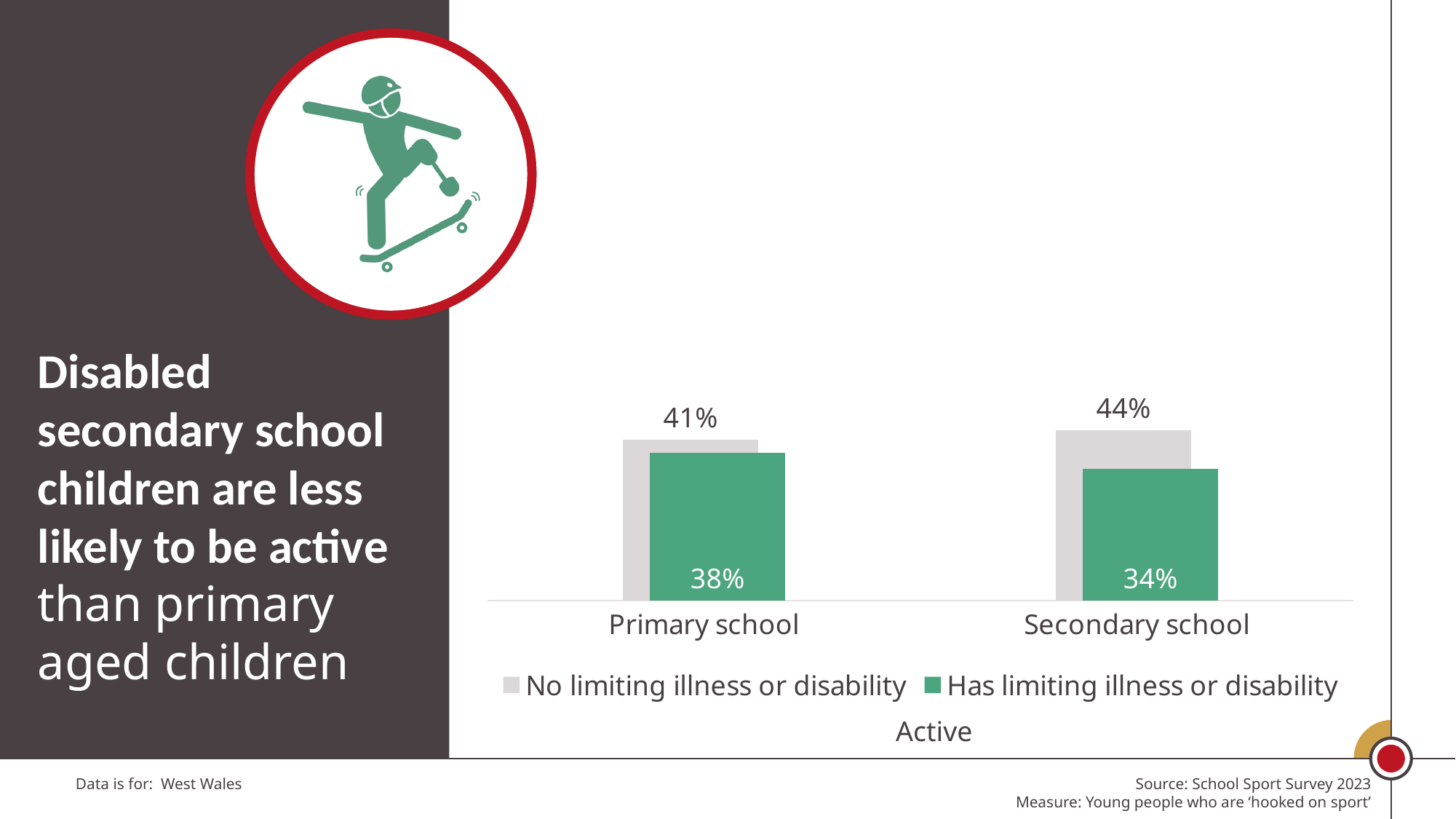
What is the value for 'No limiting illness or disability' at Primary school? 41% What kind of chart is shown on the slide? Bar chart Which category has the highest value for 'No limiting illness or disability'? Secondary school What is the value for 'Has limiting illness or disability' at Secondary school? 34% What is the difference between the 'No limiting illness or disability' and 'Has limiting illness or disability' values at Secondary school? 10% Which is larger: the 'Has limiting illness or disability' value at Primary school or at Secondary school? Primary school How many series does the legend list? 2 How many categories are shown on the x axis? 2 What is the difference between the 'Has limiting illness or disability' values for Primary school and Secondary school? 4% What is the value for 'No limiting illness or disability' at Secondary school? 44% What is the value for 'Has limiting illness or disability' at Primary school? 38% Which category has the lowest value for 'Has limiting illness or disability'? Secondary school